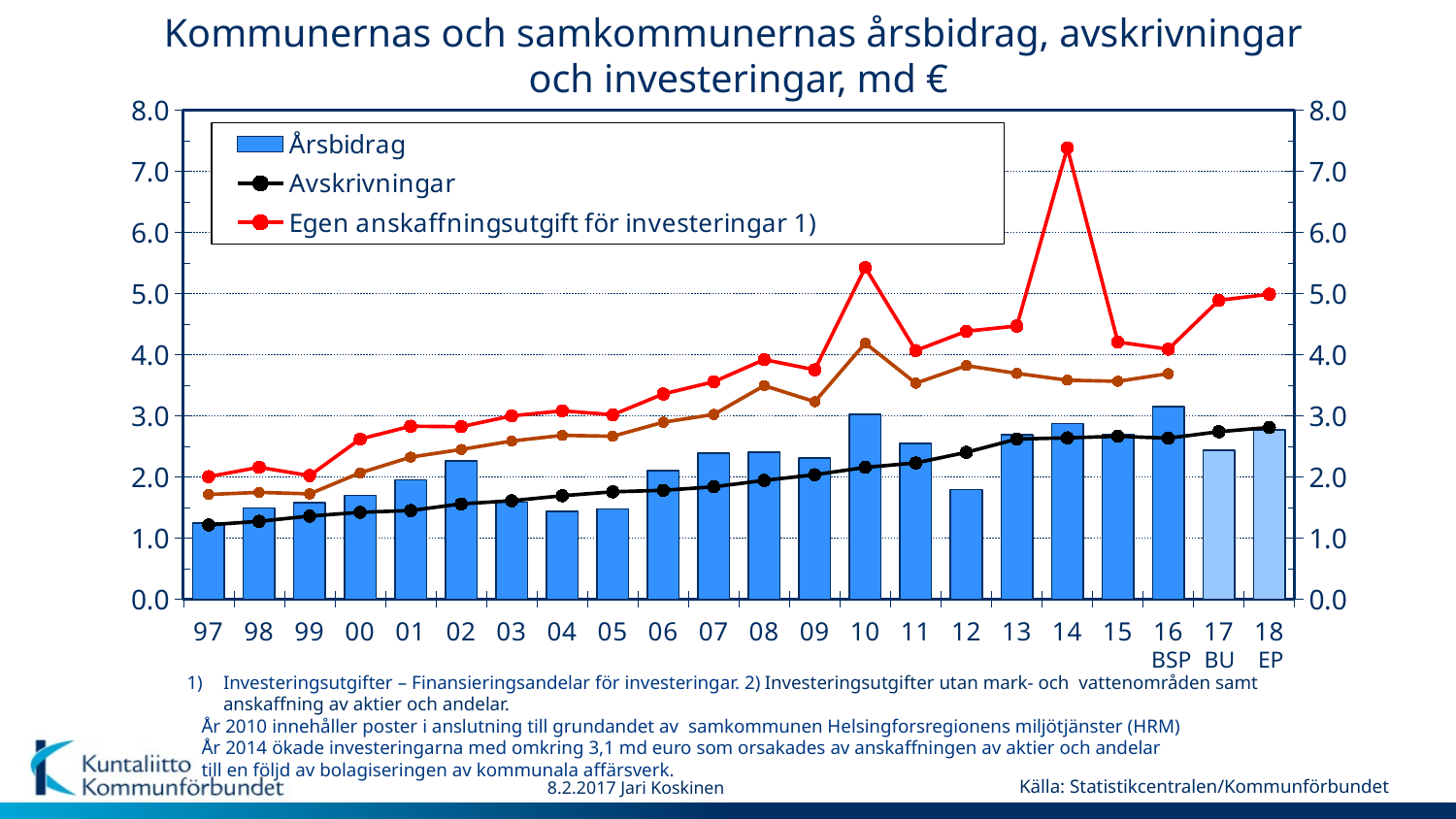
How many series does the legend list? 3 Is the value of 'Egen anskaffningsutgift för investeringar 1)' for 14 greater or less than 7.0? greater In which year is the Årsbidrag bar the lowest? 97 Is the Årsbidrag value for 04 greater or less than 2.0? less Is the value of 'Egen anskaffningsutgift för investeringar 1)' for 10 greater or less than 5.0? greater In which year does the 'Egen anskaffningsutgift för investeringar 1)' line reach its highest value? 14 Does the Avskrivningar line generally rise or fall from 97 to 18? rise What kind of chart is shown on the slide? A combined bar and line chart How many years are shown along the x axis? 22 Which series is shown as bars in the legend? Årsbidrag Which year has the larger Årsbidrag bar, 10 or 12? 10